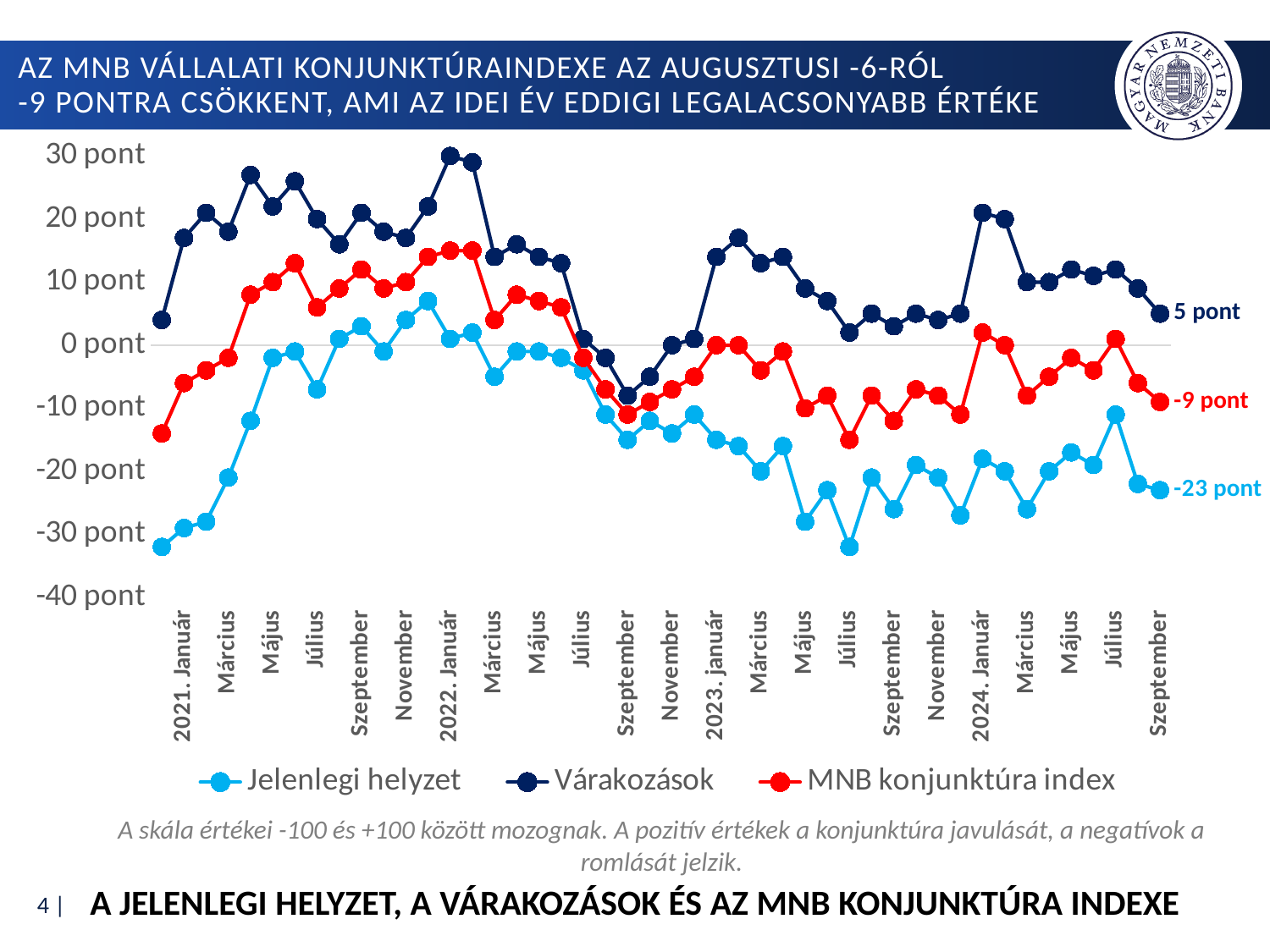
At 2024 Szeptember, which series has the higher value: Várakozások or Jelenlegi helyzet? Várakozások Which series has the lowest value at 2024 Szeptember? Jelenlegi helyzet How many series does the legend list? 3 What kind of chart is shown on the slide? line chart Does the Jelenlegi helyzet series rise or fall from 2021. Január to 2021 Szeptember? rise What is the value of the Jelenlegi helyzet series at the last point (2024 Szeptember)? -23 pont What is the difference between the MNB konjunktúra index (-9 pont) and the Jelenlegi helyzet (-23 pont) at 2024 Szeptember? 14 pont What is the difference between the Várakozások value (5 pont) and the MNB konjunktúra index value (-9 pont) at 2024 Szeptember? 14 pont What is the value of the Várakozások series at the last point (2024 Szeptember)? 5 pont What is the value of the MNB konjunktúra index at the last point (2024 Szeptember)? -9 pont